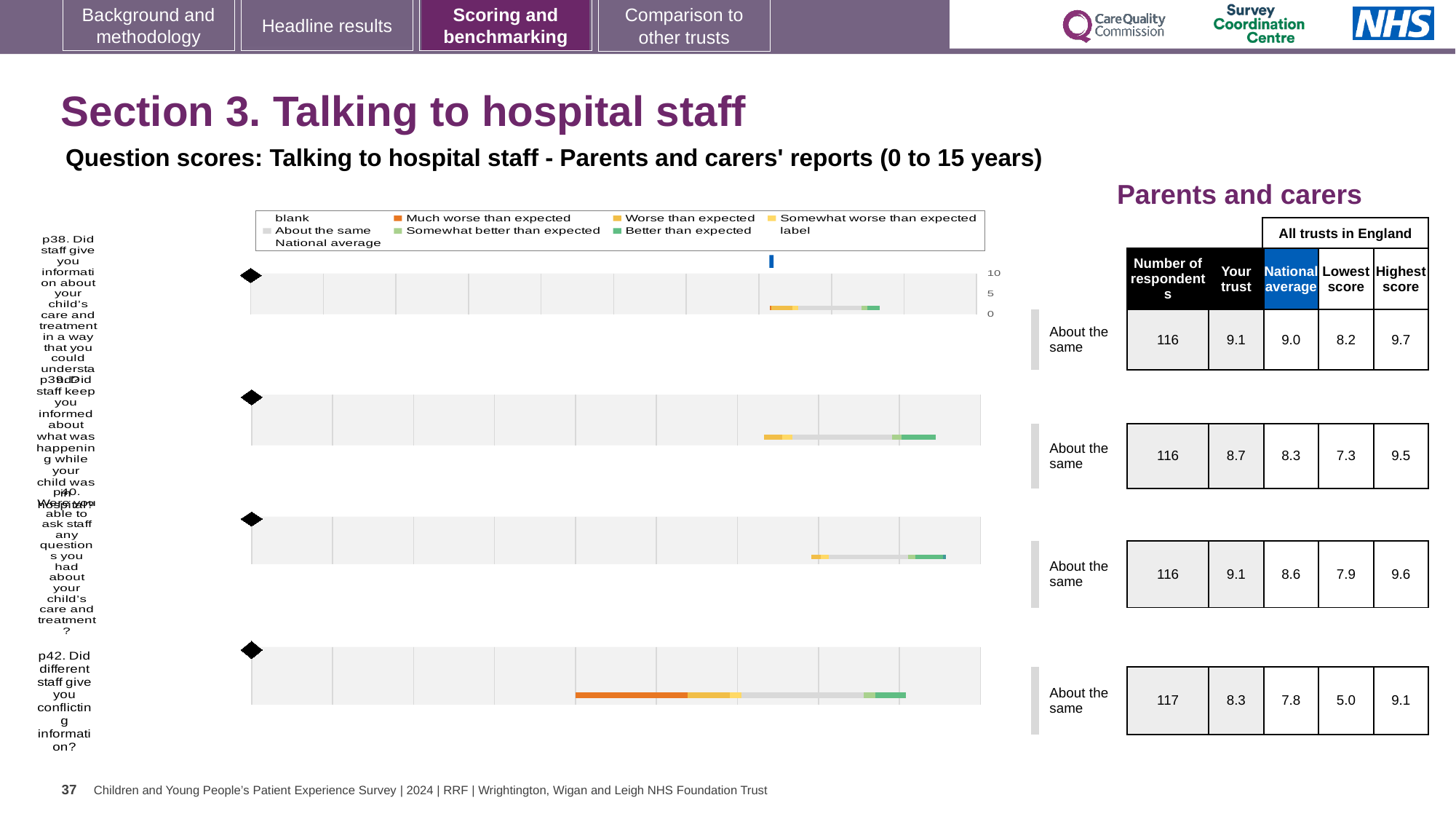
What is the national average score shown for question p42 (different staff giving conflicting information)? 7.8 In the chart legend, which colour represents 'Better than expected'? green What is the lowest score among all trusts in England for question p39 (staff keeping you informed)? 7.3 How many respondents are shown for question p42? 117 What is the highest score among all trusts in England for question p40 (being able to ask staff questions)? 9.6 In the chart legend, which colour represents 'Much worse than expected'? orange Is the 'Your trust' score for question p40 larger or smaller than the national average for that question? larger How many benchmarking bar charts are shown on the slide? 4 Which question has the lowest 'Your trust' score on this slide? p42 What kind of chart is used for the p38 question on this slide? bar chart What is the 'Your trust' score shown for question p38 (staff giving information about the child's care and treatment)? 9.1 What is the difference between the 'Your trust' score and the national average for question p39? 0.4